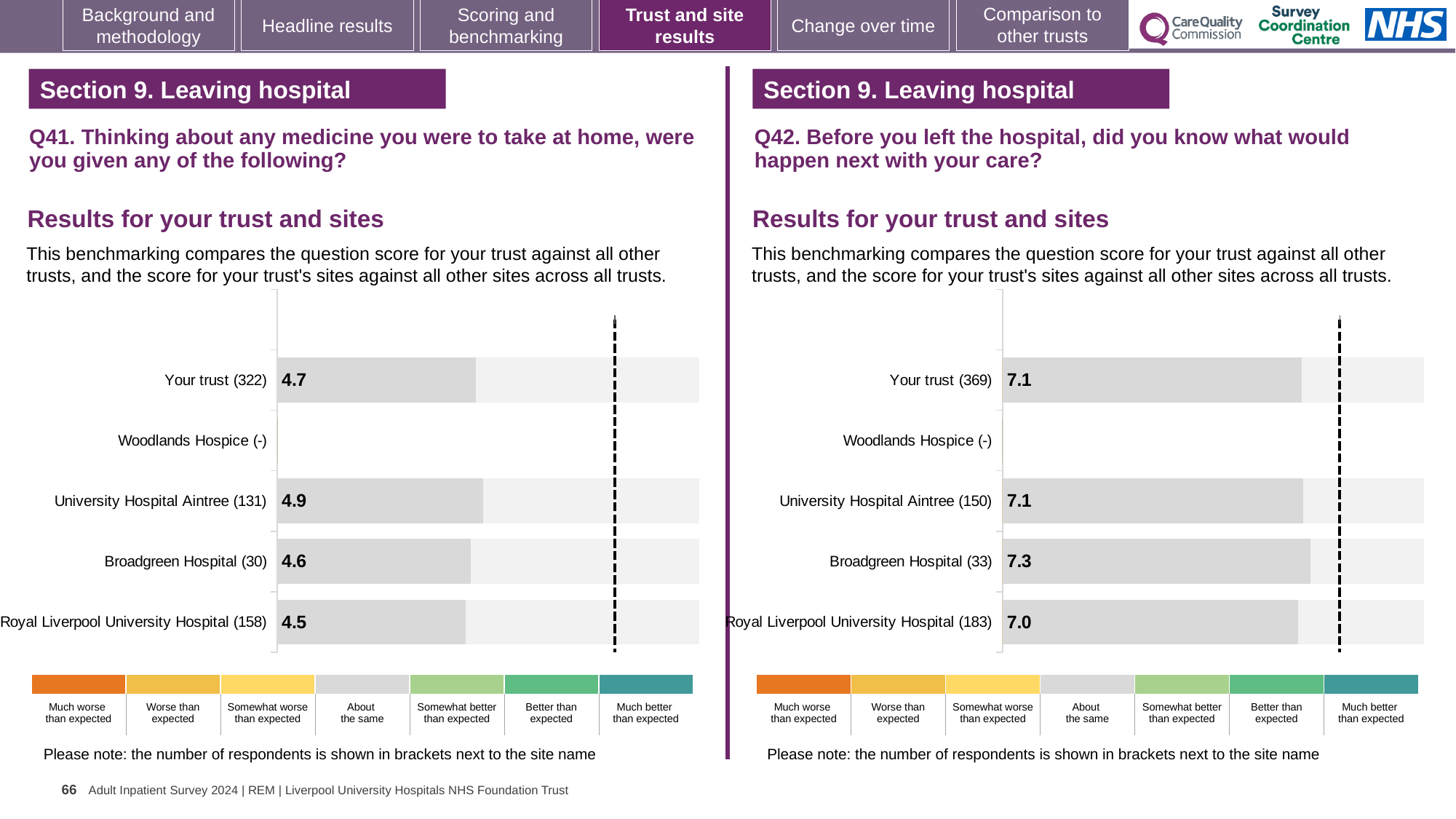
In the Q42 chart on the right, what is the score for Broadgreen Hospital (33)? 7.3 In the Q41 chart on the left, which site has no score shown? Woodlands Hospice (-) How many category labels are listed on the Q42 chart on the right? 5 In the Q42 chart on the right, what is the score for Royal Liverpool University Hospital (183)? 7.0 In the Q41 chart on the left, what is the score for Your trust (322)? 4.7 In the Q41 chart on the left, which has the higher score: Broadgreen Hospital (30) or University Hospital Aintree (131)? University Hospital Aintree (131) In the Q42 chart on the right, what is the difference between the scores for Broadgreen Hospital (33) and Royal Liverpool University Hospital (183)? 0.3 In the Q41 chart on the left, what is the score for University Hospital Aintree (131)? 4.9 In the Q42 chart on the right, which site has the highest score? Broadgreen Hospital (33) In the Q41 chart on the left, which site has the lowest score? Royal Liverpool University Hospital (158) In the Q41 chart on the left, what is the difference between the scores for University Hospital Aintree (131) and Royal Liverpool University Hospital (158)? 0.4 What kind of chart is the Q41 chart on the left? Bar chart